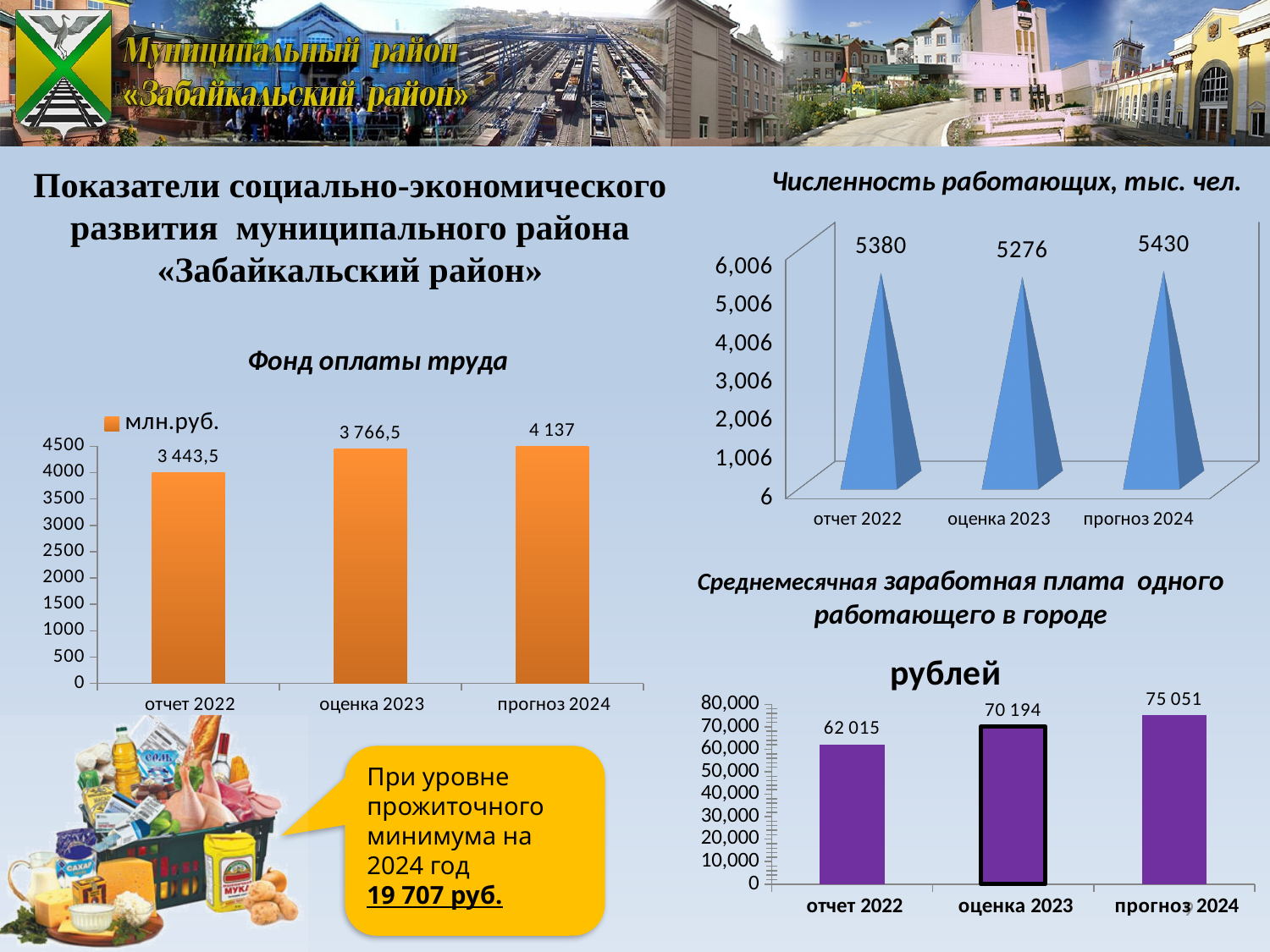
In the 'Фонд оплаты труда' chart, what series name does the legend show? млн.руб. What type of chart is the 'Среднемесячная заработная плата одного работающего в городе' chart? bar chart In the 'Среднемесячная заработная плата одного работающего в городе' chart, which is larger: 'оценка 2023' or 'прогноз 2024'? прогноз 2024 In the 'Фонд оплаты труда' chart, what is the value for 'оценка 2023'? 3 766,5 In the 'Численность работающих, тыс. чел.' chart, what is the value for 'оценка 2023'? 5276 In the 'Численность работающих, тыс. чел.' chart, how many categories are shown? 3 In the 'Численность работающих, тыс. чел.' chart, which category has the lowest value? оценка 2023 In the 'Фонд оплаты труда' chart, what is the difference between 'прогноз 2024' and 'отчет 2022'? 693,5 In the 'Фонд оплаты труда' chart, which category has the highest value? прогноз 2024 In the 'Численность работающих, тыс. чел.' chart, what is the difference between 'прогноз 2024' and 'отчет 2022'? 50 In the 'Среднемесячная заработная плата одного работающего в городе' chart, what is the value for 'отчет 2022'? 62 015 In the 'Среднемесячная заработная плата одного работающего в городе' chart, do the values rise or fall from 'отчет 2022' to 'прогноз 2024'? rise